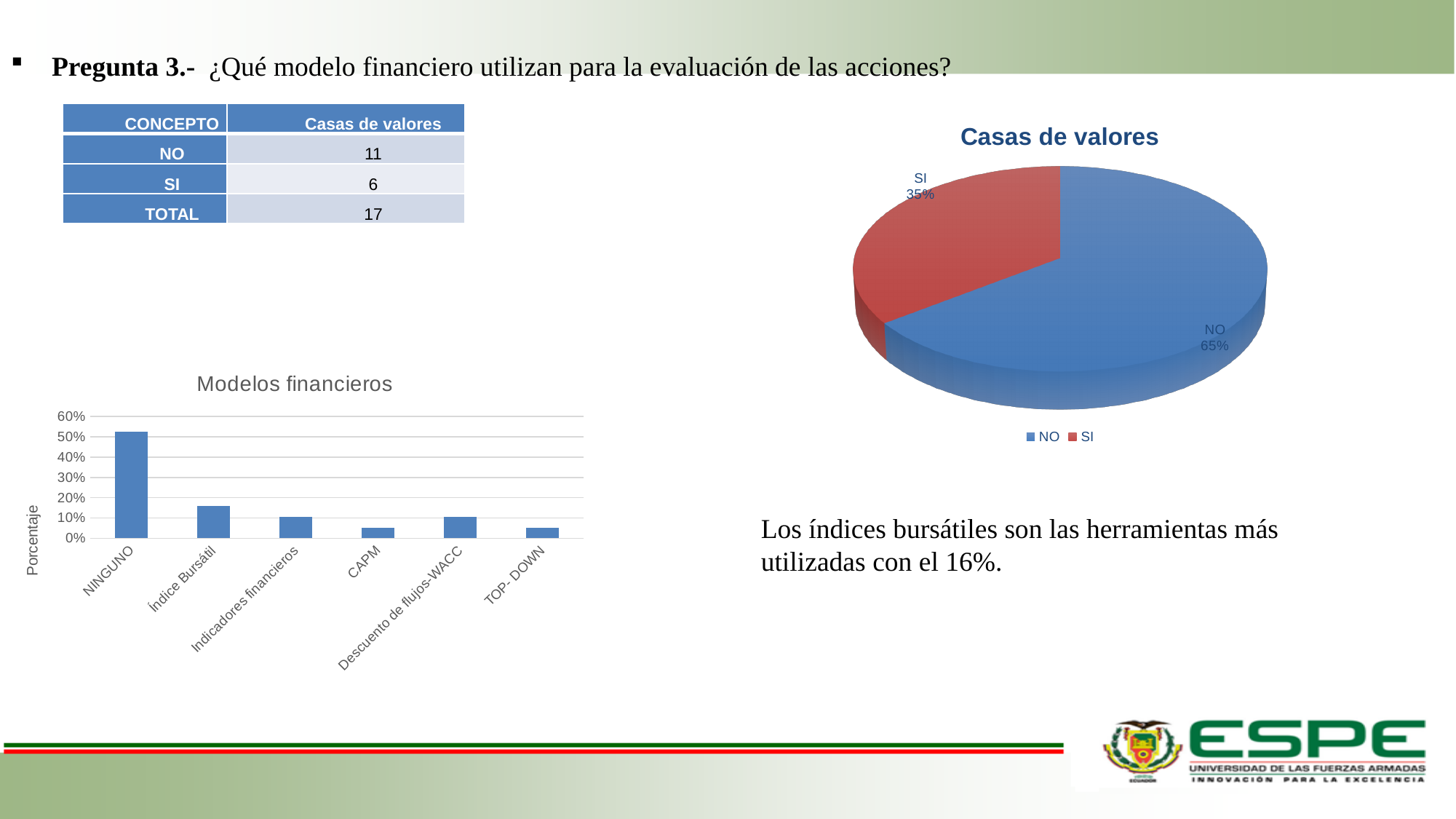
In the 'Modelos financieros' chart, what is the label on the vertical axis? Porcentaje In the 'Casas de valores' pie chart, what percentage is shown for SI? 35% In the 'Casas de valores' pie chart, what is the difference in percentage points between NO and SI? 30 percentage points What kind of chart is the 'Modelos financieros' chart? Bar chart In the 'Modelos financieros' chart, which category has the highest bar? NINGUNO In the 'Casas de valores' pie chart, which slice is the largest? NO What kind of chart is the 'Casas de valores' chart? Pie chart How many entries does the legend of the 'Casas de valores' chart list? 2 In the 'Casas de valores' pie chart, what percentage is shown for NO? 65% In the 'Modelos financieros' chart, is the value for NINGUNO greater or less than 50%? greater In the 'Modelos financieros' chart, is the value for CAPM greater or less than 10%? less How many categories are shown on the x axis of the 'Modelos financieros' chart? 6